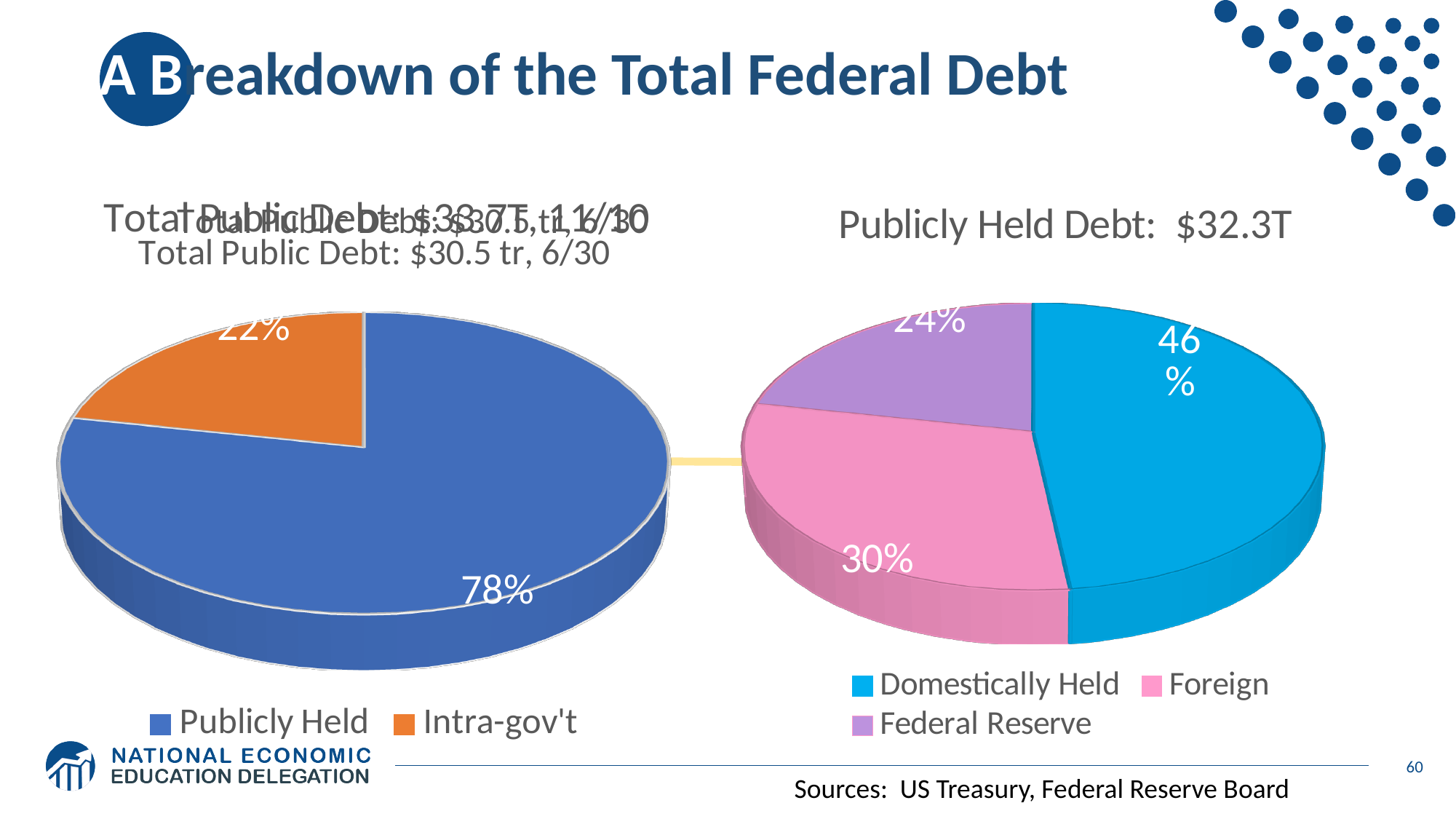
On the left pie chart, what share of the total public debt is Publicly Held? 78% On the left pie chart, what is the difference in percentage points between the Publicly Held and Intra-gov't slices? 56 On the left pie chart, which slice is the largest? Publicly Held On the 'Publicly Held Debt: $32.3T' chart, how many categories does the legend list? 3 On the 'Publicly Held Debt: $32.3T' chart, what share is held by the Federal Reserve? 24% What kind of chart is the 'Publicly Held Debt: $32.3T' chart? Pie chart On the 'Publicly Held Debt: $32.3T' chart, which slice is the smallest? Federal Reserve On the 'Publicly Held Debt: $32.3T' chart, what share is Domestically Held? 46% On the 'Publicly Held Debt: $32.3T' chart, which is larger, the Foreign slice or the Federal Reserve slice? Foreign On the left pie chart, what share of the total public debt is Intra-gov't? 22% On the left pie chart, how many slices does the pie have? 2 On the 'Publicly Held Debt: $32.3T' chart, what share is Foreign? 30%